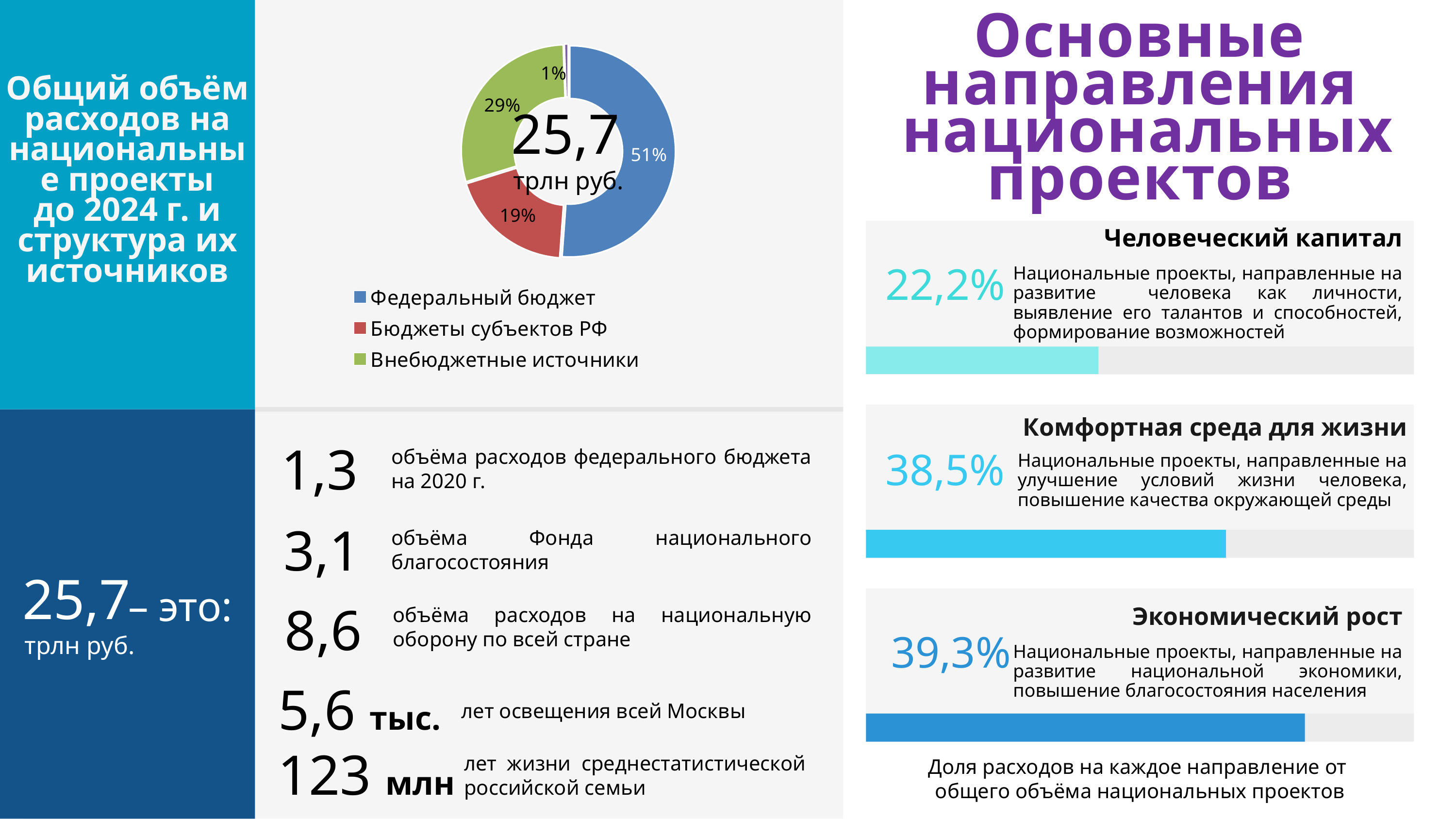
In the donut chart, what share is shown for Бюджеты субъектов РФ? 19% What colour represents Внебюджетные источники in the donut chart? Green Of the three sources listed in the legend, which has the smallest share in the donut chart? Бюджеты субъектов РФ What type of chart is used to show the structure of funding sources on the slide? Pie (donut) chart Which source has the largest share in the donut chart? Федеральный бюджет How many entries does the legend of the donut chart list? 3 In the donut chart, what share is shown for Федеральный бюджет? 51% Which has the larger share in the donut chart: Внебюджетные источники or Бюджеты субъектов РФ? Внебюджетные источники What total value is printed in the centre of the donut chart? 25,7 трлн руб. By how many percentage points does the share of Федеральный бюджет exceed the share of Бюджеты субъектов РФ in the donut chart? 32 percentage points How many percentage labels are printed on the donut chart? 4 In the donut chart, what share is shown for Внебюджетные источники? 29%